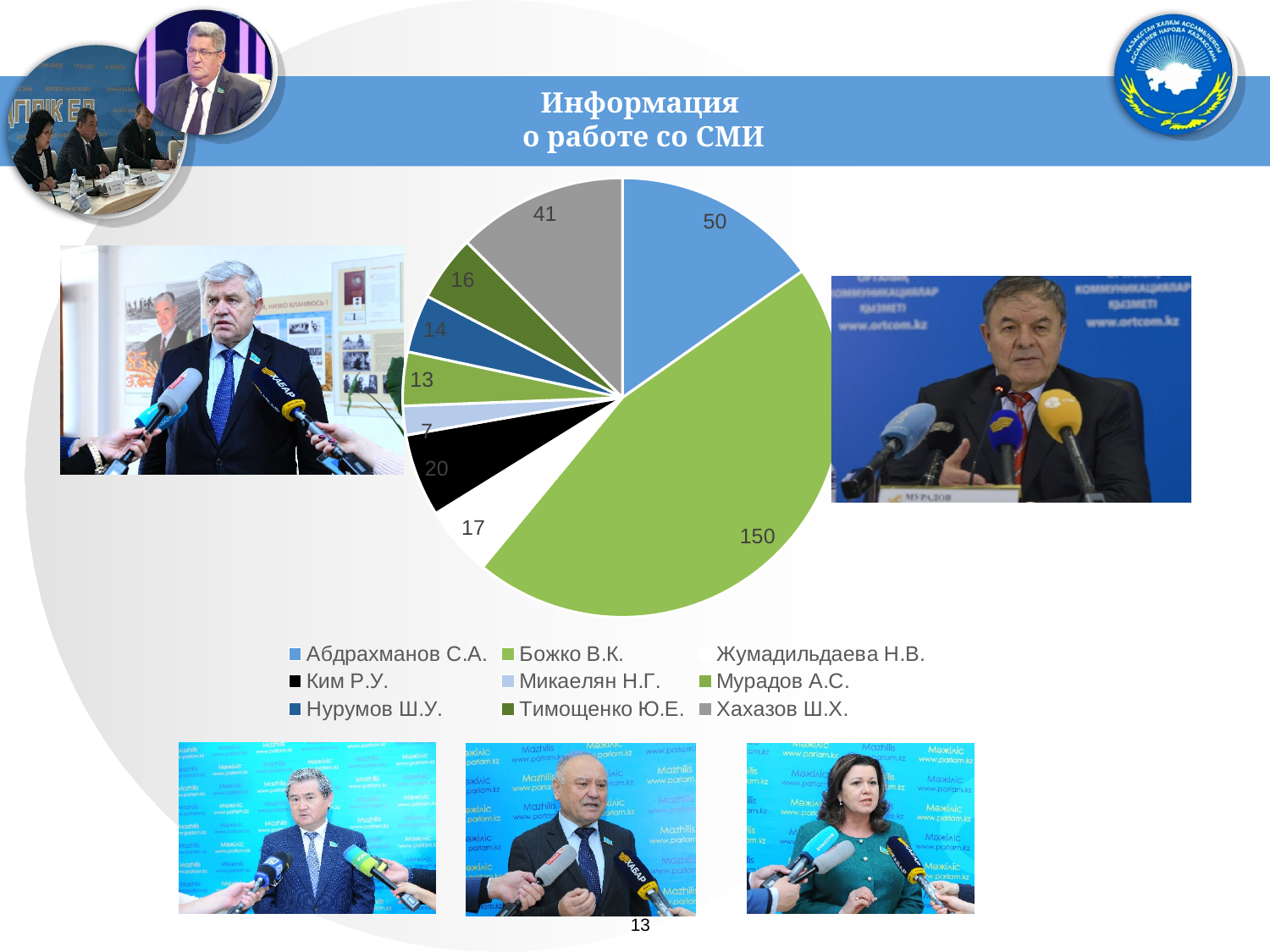
What is the value for Хахазов Ш.Х.? 41 Which person has the smallest slice of the pie chart? Микаелян Н.Г. What is the value for Абдрахманов С.А.? 50 Which is larger, the value for Ким Р.У. or the value for Жумадильдаева Н.В.? Ким Р.У. How many entries does the legend list? 9 What is the title of the chart? Информация о работе со СМИ How many slices does the pie chart have? 9 What kind of chart is shown on the slide? pie chart What is the value for Божко В.К.? 150 What is the difference between the values for Божко В.К. and Абдрахманов С.А.? 100 What is the total of all the values in the pie chart? 328 Which person has the largest slice of the pie chart? Божко В.К.